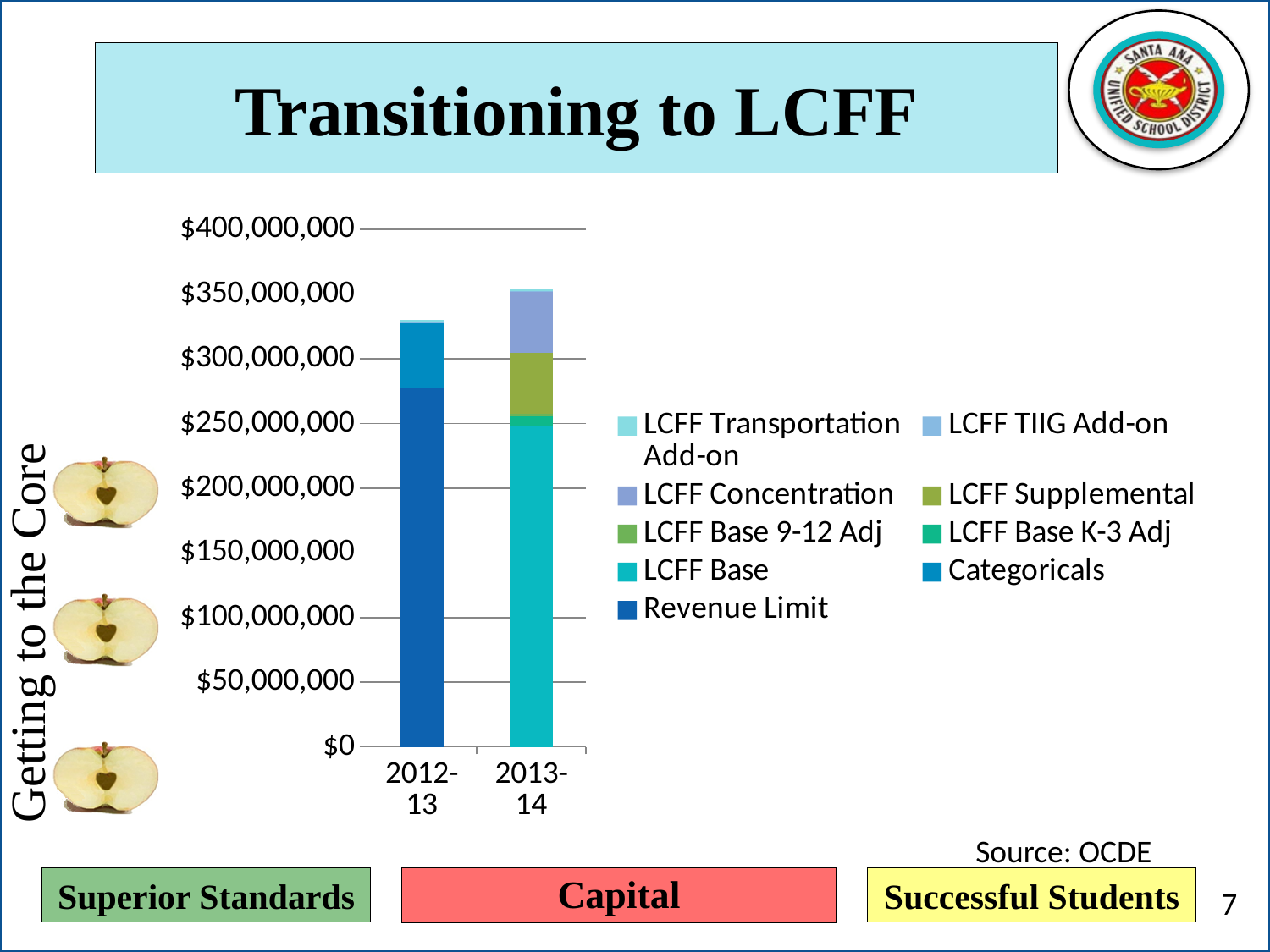
Do the total bar values rise or fall from 2012-13 to 2013-14? rise Is the total value of the 2013-14 bar greater or less than $300,000,000? greater How many categories are shown on the x axis of the chart? 2 Is the total value of the 2012-13 bar greater or less than $350,000,000? less Is the Revenue Limit segment for 2012-13 greater or less than $250,000,000? greater What kind of chart is shown on the slide? stacked bar chart How many series does the chart's legend list? 9 Which year has the taller total bar, 2012-13 or 2013-14? 2013-14 Which series in the legend is shown in dark blue at the bottom of the 2012-13 bar? Revenue Limit What is the title of the slide containing the chart? Transitioning to LCFF